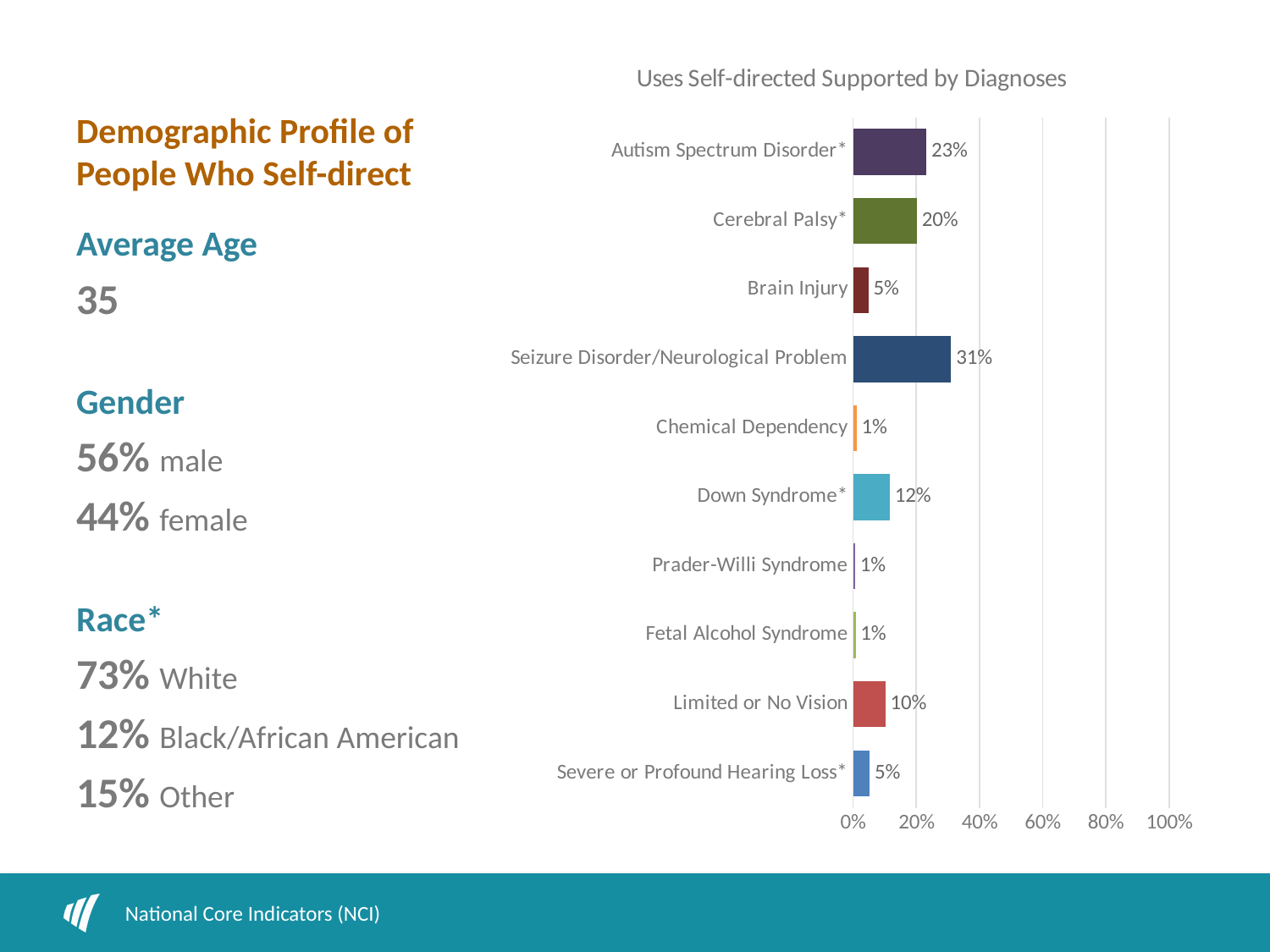
What is the value for Cerebral Palsy*? 20% What is the value for Seizure Disorder/Neurological Problem? 31% Which diagnosis has the highest value? Seizure Disorder/Neurological Problem What is the difference between the values for Autism Spectrum Disorder* and Down Syndrome*? 11% What is the difference between the values for Seizure Disorder/Neurological Problem and Cerebral Palsy*? 11% How many diagnosis categories are shown in the chart? 10 What kind of chart is shown on the slide? bar chart Which is larger, the value for Brain Injury or the value for Limited or No Vision? Limited or No Vision What is the title of the chart? Uses Self-directed Supported by Diagnoses Is the value for Seizure Disorder/Neurological Problem greater or less than 20%? greater What is the highest value shown on the x axis? 100% What is the value for Limited or No Vision? 10%